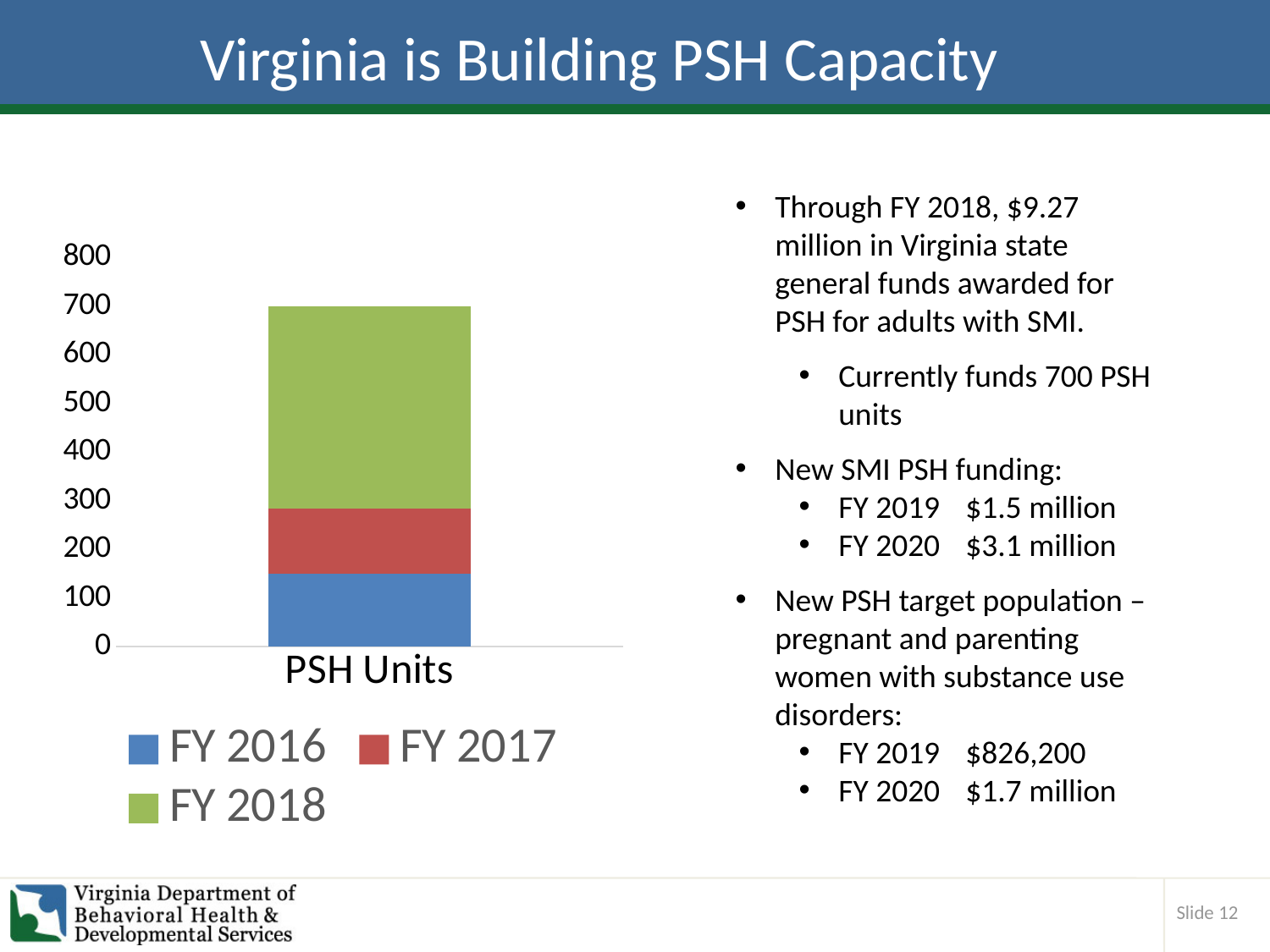
Which segment is larger in the PSH Units bar, FY 2018 or FY 2016? FY 2018 What is the total height of the stacked PSH Units bar? 700 Is the FY 2016 segment of the PSH Units bar greater or less than 100? greater How many series does the chart legend list? 3 What kind of chart is shown on the slide? Stacked bar chart Is the FY 2018 segment of the PSH Units bar greater or less than 300? greater Which series contributes the largest segment to the PSH Units bar? FY 2018 Which colour represents FY 2018 in the chart legend? Green Is the FY 2017 segment of the PSH Units bar greater or less than 200? less What is the label of the single category on the chart's x axis? PSH Units How many categories are plotted on the x axis of the chart? 1